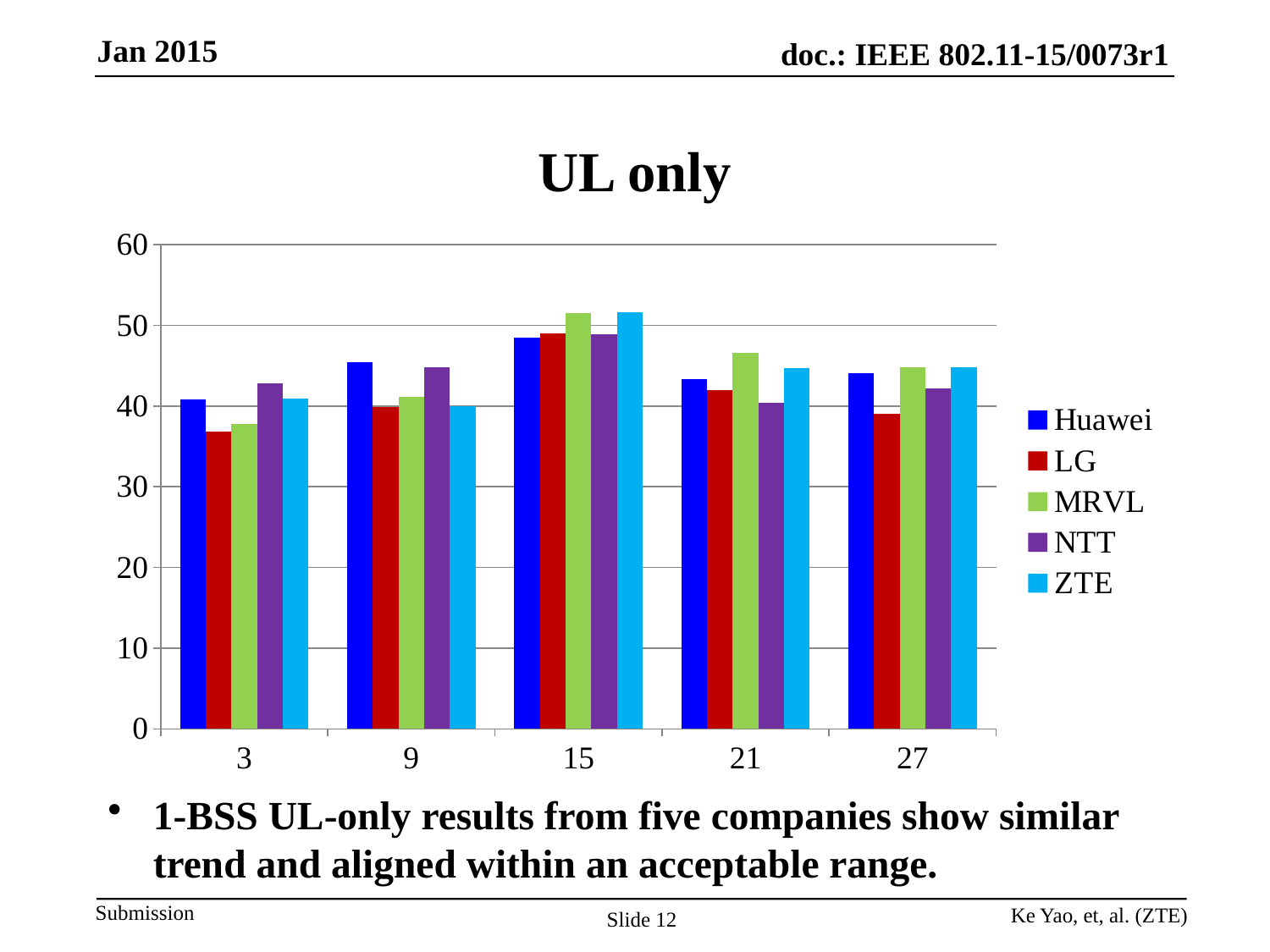
How many series does the legend list? 5 Is the value for LG at category 27 greater or less than 40? less Which series has the lowest value at category 27? LG Is the value for LG at category 3 greater or less than 40? less What kind of chart is shown on the slide? bar chart Is the value for Huawei at category 9 greater or less than 40? greater Which is larger for Huawei: the value at category 3 or at category 15? category 15 Which series has the highest value at category 3? NTT Do the Huawei values rise or fall from category 3 to category 15? rise How many categories are shown on the x axis? 5 What is the title of the chart? UL only